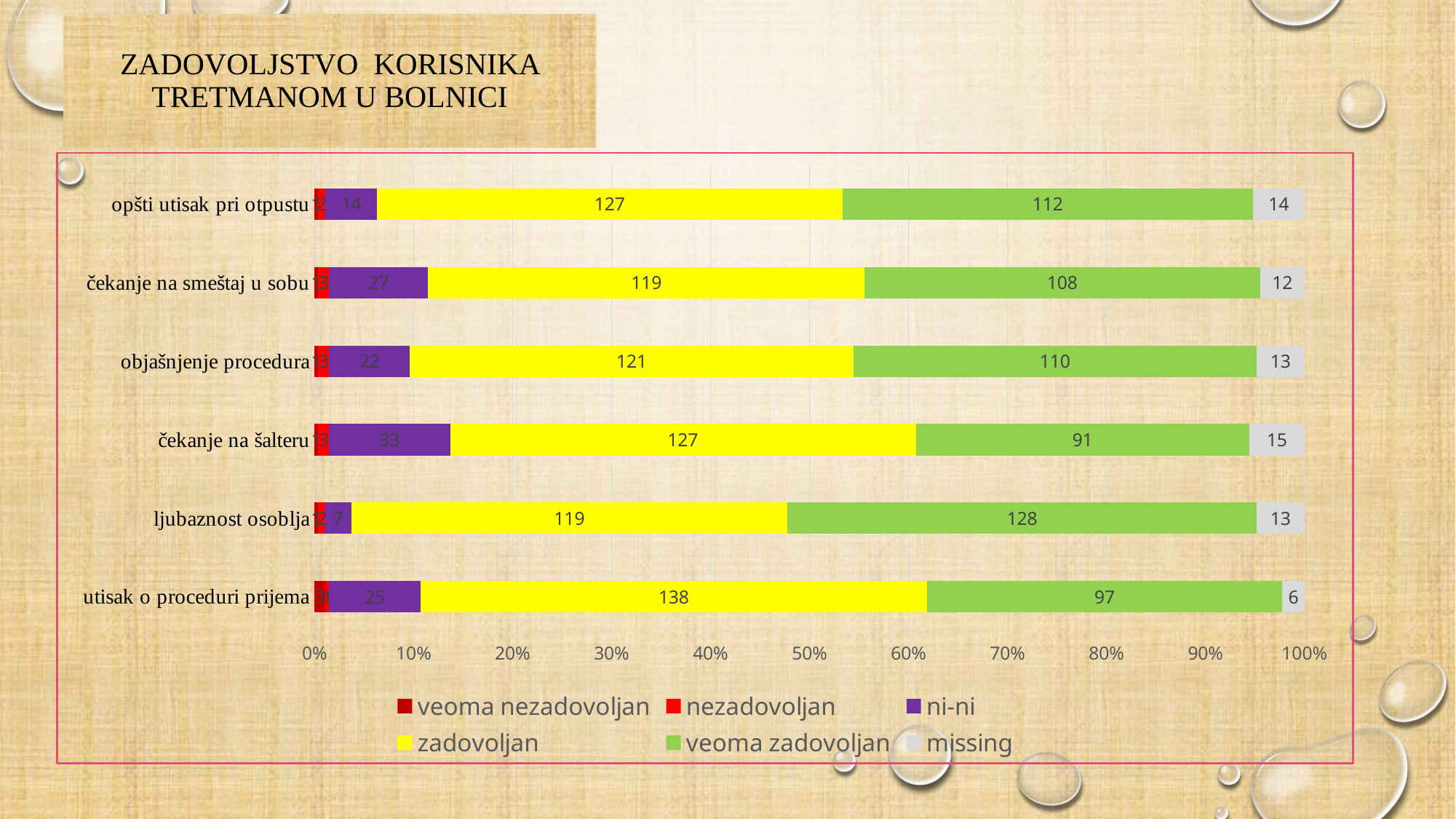
What colour represents the 'zadovoljan' series? yellow Which category has the highest 'ni-ni' value? čekanje na šalteru What is the 'missing' value for 'utisak o proceduri prijema'? 6 Which category has the lowest 'veoma zadovoljan' value? čekanje na šalteru How many categories are plotted on the chart? 6 What is the 'ni-ni' value for 'čekanje na šalteru'? 33 What is the 'zadovoljan' value for 'utisak o proceduri prijema'? 138 How many series does the legend list? 6 What is the difference between the 'zadovoljan' and 'veoma zadovoljan' values for 'čekanje na šalteru'? 36 Which is larger for 'ljubaznost osoblja': the 'zadovoljan' value or the 'veoma zadovoljan' value? veoma zadovoljan What kind of chart is shown on the slide? stacked bar chart What is the 'veoma zadovoljan' value for 'ljubaznost osoblja'? 128